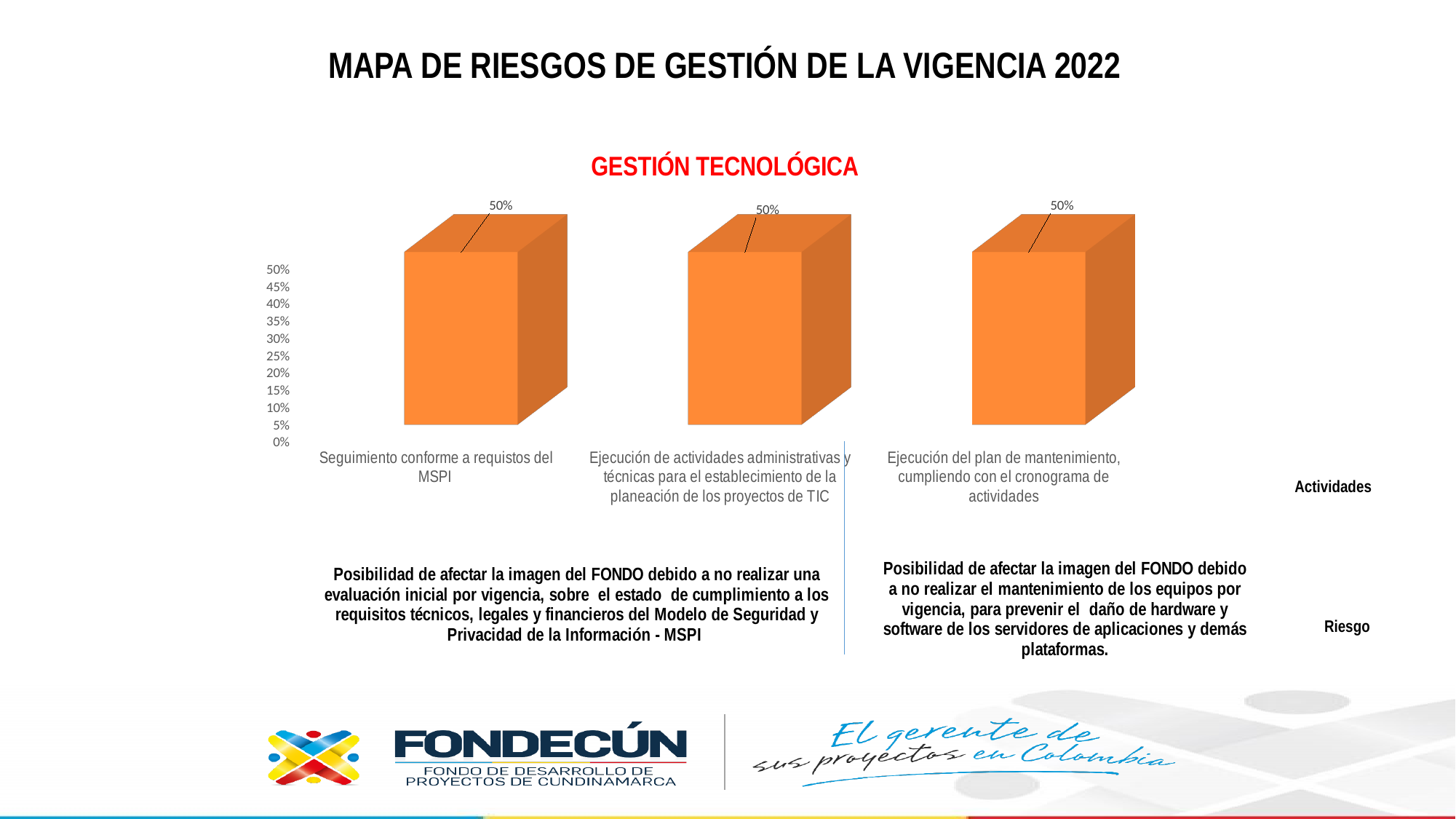
What is the title of the chart? GESTIÓN TECNOLÓGICA What is the value for "Seguimiento conforme a requistos del MSPI"? 50% Is the value for "Seguimiento conforme a requistos del MSPI" greater or less than 25%? greater What is the value for "Ejecución del plan de mantenimiento, cumpliendo con el cronograma de actividades"? 50% Is the value for "Ejecución del plan de mantenimiento, cumpliendo con el cronograma de actividades" greater or less than 10%? greater What is the highest value shown on the vertical axis of the chart? 50% How many categories are plotted in the chart? 3 Do the values rise, fall or stay the same across the categories from left to right? Stay the same What kind of chart is shown on the slide? Bar chart What is the value for "Ejecución de actividades administrativas y técnicas para el establecimiento de la planeación de los proyectos de TIC"? 50% What is the difference between the value for "Seguimiento conforme a requistos del MSPI" and the value for "Ejecución del plan de mantenimiento, cumpliendo con el cronograma de actividades"? 0%